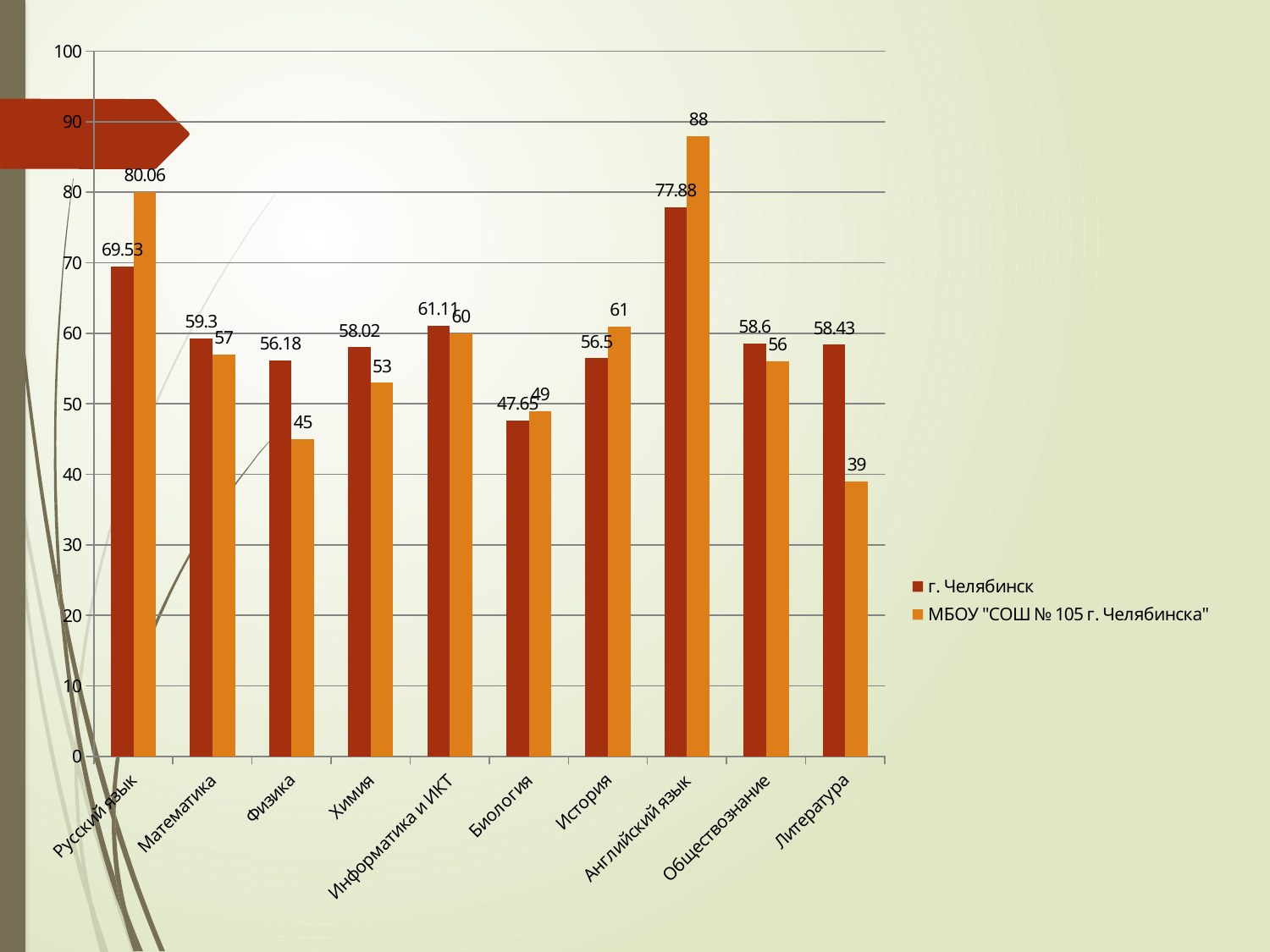
How many series does the legend list? 2 Which colour represents the series МБОУ "СОШ № 105 г. Челябинска" in the legend? orange Which subject has the highest value for г. Челябинск? Английский язык Which subject has the lowest value for МБОУ "СОШ № 105 г. Челябинска"? Литература What kind of chart is shown on the slide? bar chart In Физика, which series has the larger value: г. Челябинск or МБОУ "СОШ № 105 г. Челябинска"? г. Челябинск How many subject categories are shown on the x axis? 10 What is the difference between the МБОУ "СОШ № 105 г. Челябинска" value and the г. Челябинск value in Русский язык? 10.53 What is the value for МБОУ "СОШ № 105 г. Челябинска" in Английский язык? 88 What is the value for МБОУ "СОШ № 105 г. Челябинска" in Литература? 39 Is the value for г. Челябинск in Биология greater or less than 50? less What is the value for г. Челябинск in Русский язык? 69.53